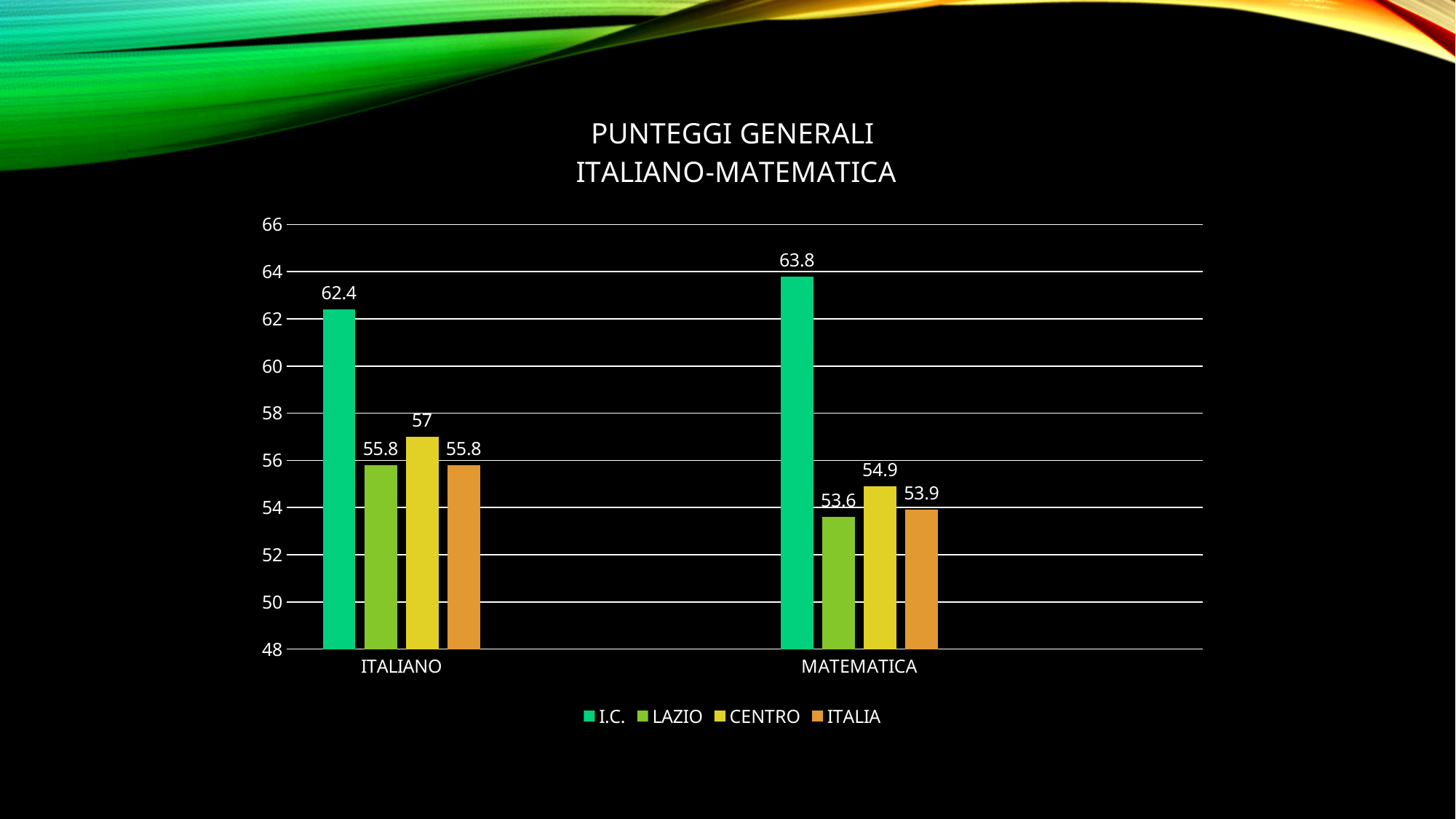
How many categories are shown on the x axis? 2 What is the LAZIO value for MATEMATICA? 53.6 Which is larger, the I.C. value for ITALIANO or the I.C. value for MATEMATICA? MATEMATICA What kind of chart is shown on the slide? Bar chart What is the ITALIA value for MATEMATICA? 53.9 Which series has the highest value for MATEMATICA? I.C. Which series has the lowest value for MATEMATICA? LAZIO What is the title of the chart? PUNTEGGI GENERALI ITALIANO-MATEMATICA How many series does the legend list? 4 What is the I.C. value for ITALIANO? 62.4 What is the difference between the I.C. value and the CENTRO value for ITALIANO? 5.4 What is the CENTRO value for ITALIANO? 57